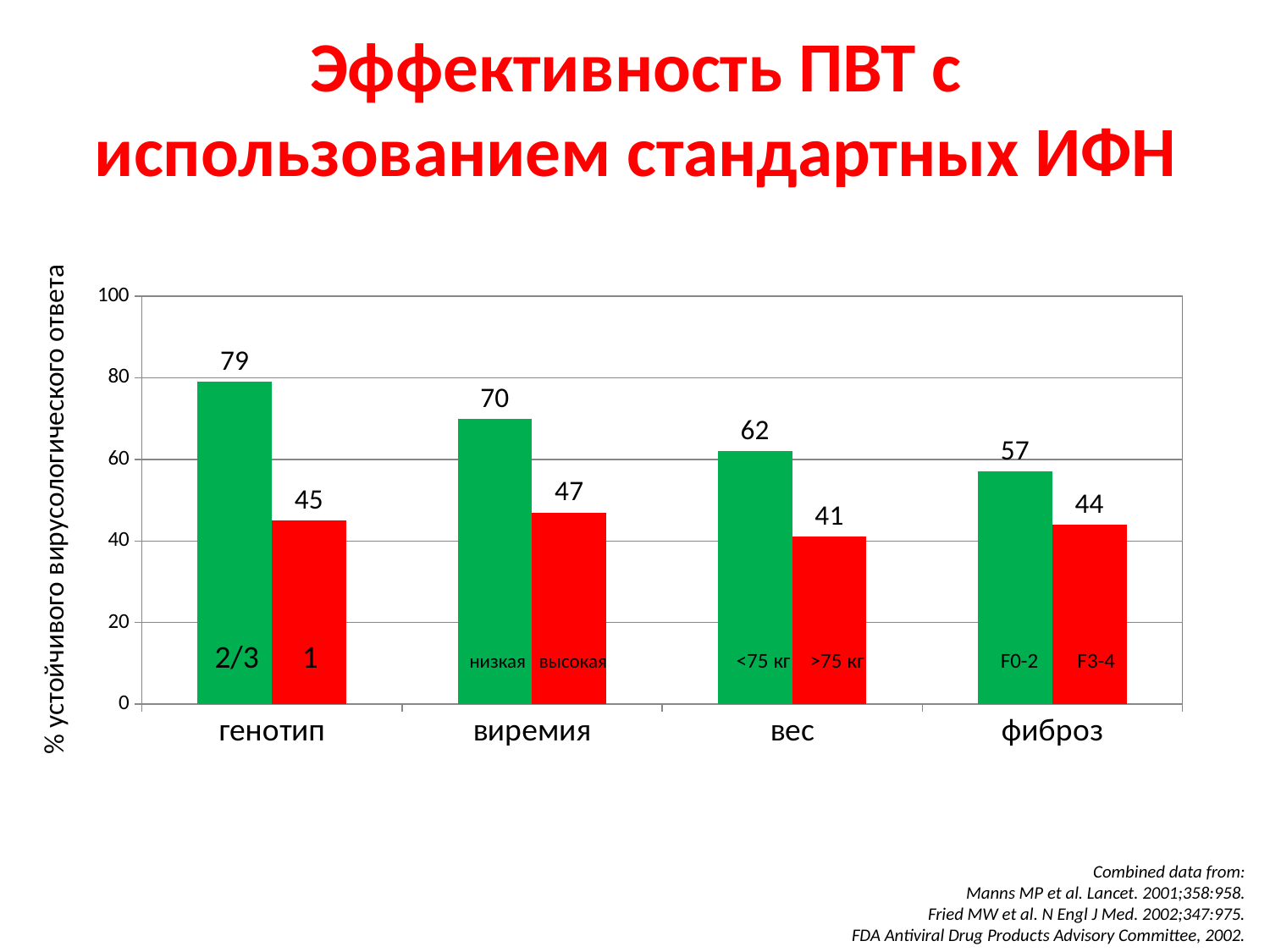
What is the label of the y axis? % устойчивого вирусологического ответа Which bar has the lowest value on the chart? >75 кг (вес), 41 What is the value of the bar labelled высокая in the виремия category? 47 Which bar has the highest value on the chart? 2/3 (генотип), 79 What is the value of the green bar for genotype 2/3 in the генотип category? 79 What type of chart is shown on the slide? bar chart Which is larger: the value for F0-2 or the value for низкая? низкая What is the value of the red bar for genotype 1 in the генотип category? 45 What is the value of the bar labelled F3-4 in the фиброз category? 44 What is the value of the bar labelled <75 кг in the вес category? 62 How many categories are shown on the x axis? 4 What is the difference between the green and red bars in the виремия category? 23